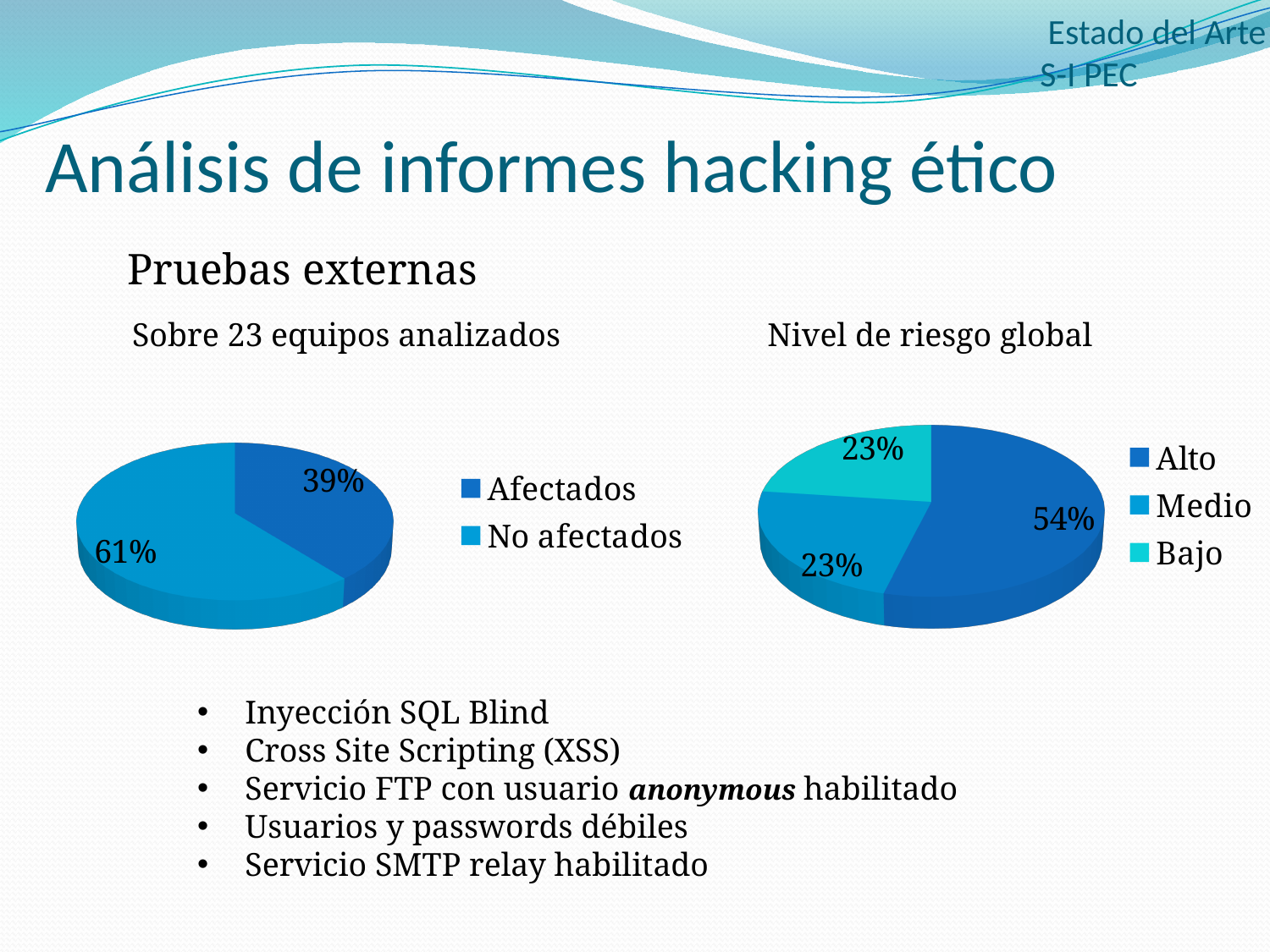
What is the title of the pie chart on the right side of the slide? Nivel de riesgo global In the right pie chart (Nivel de riesgo global), what share is labelled Alto? 54% In the right pie chart (Nivel de riesgo global), what share is labelled Bajo? 23% In the left pie chart (Sobre 23 equipos analizados), what share is labelled No afectados? 61% In the left pie chart (Sobre 23 equipos analizados), what is the difference in percentage points between No afectados and Afectados? 22 percentage points What type of chart is used for Nivel de riesgo global? Pie chart How many slices does the left pie chart (Sobre 23 equipos analizados) have? 2 In the right pie chart (Nivel de riesgo global), which category has the largest share? Alto How many categories does the legend of the right pie chart (Nivel de riesgo global) list? 3 In the left pie chart (Sobre 23 equipos analizados), what share is labelled Afectados? 39% In the left pie chart (Sobre 23 equipos analizados), which slice is larger, Afectados or No afectados? No afectados In the right pie chart (Nivel de riesgo global), what share is labelled Medio? 23%